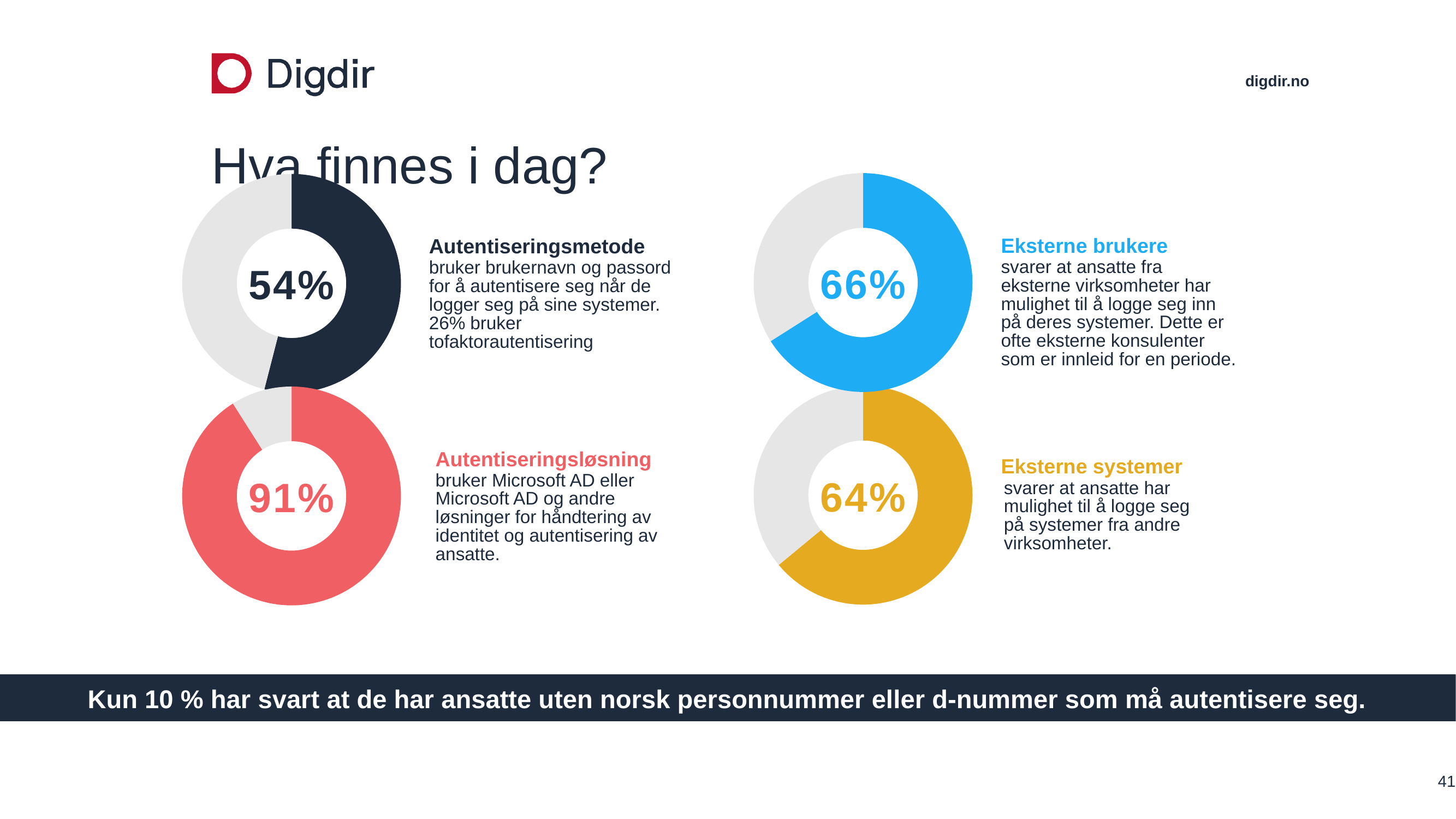
What percentage is shown in the Eksterne systemer donut chart? 64% Which of the four donut charts shows the lowest percentage? Autentiseringsmetode How many donut charts are on the slide? 4 What is the difference between the Autentiseringsløsning percentage and the Autentiseringsmetode percentage? 37% Which of the four donut charts shows the highest percentage? Autentiseringsløsning What type of chart is used to show the percentages on this slide? Donut chart Which is larger, the percentage in the Eksterne brukere chart or the Eksterne systemer chart? Eksterne brukere What percentage is shown in the Autentiseringsmetode donut chart? 54% What percentage is shown in the Autentiseringsløsning donut chart? 91% What is the difference between the Eksterne brukere percentage and the Eksterne systemer percentage? 2% What colour is the filled segment of the Eksterne systemer donut chart? Yellow What percentage is shown in the Eksterne brukere donut chart? 66%